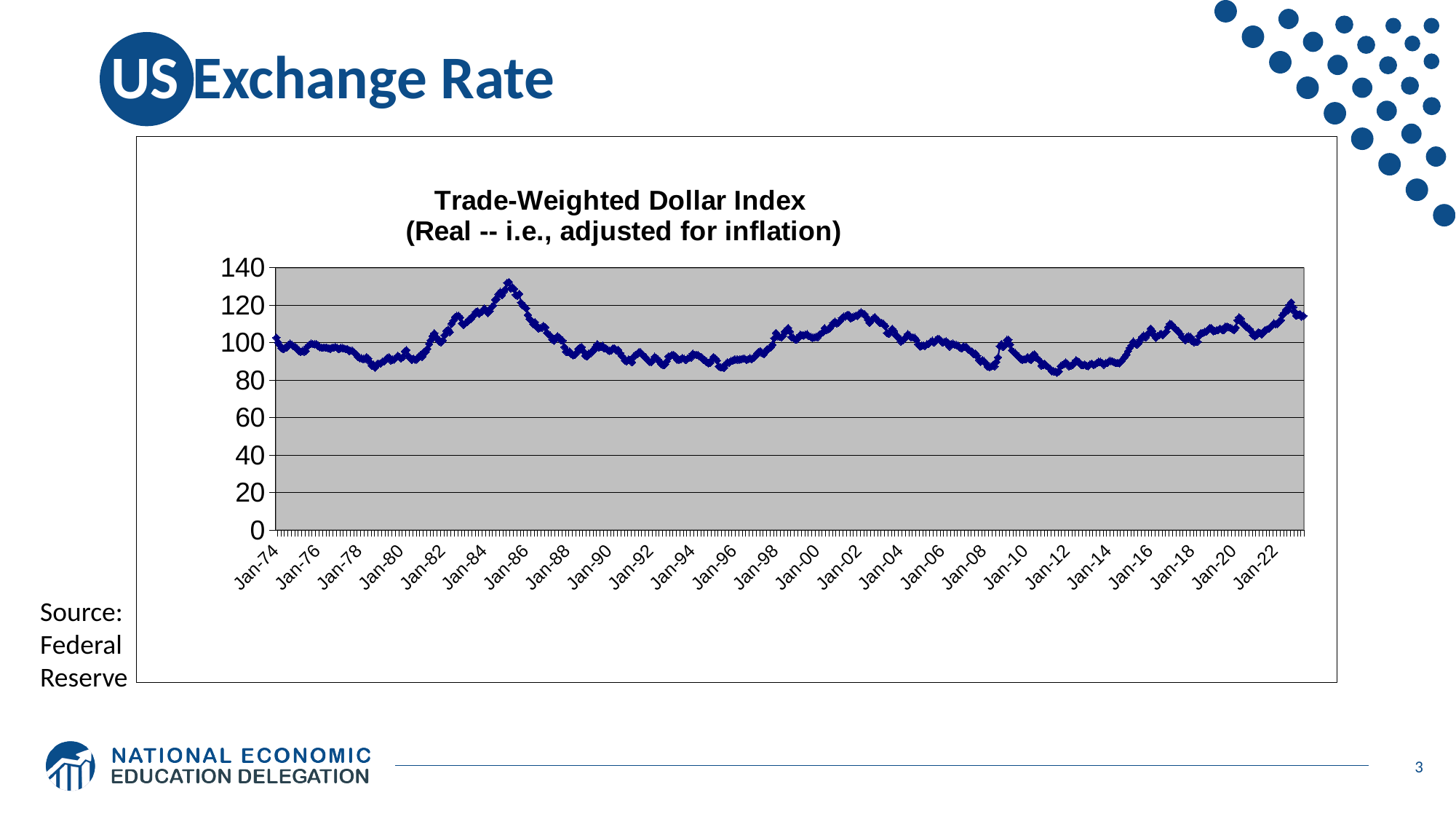
Is the peak value of the index near Jan-86 greater or less than 120? greater Is the value of the index at Jan-96 greater or less than 100? less What kind of chart is shown on the slide? line chart Is the value of the index at Jan-22 greater or less than 100? greater Around which x-axis label does the Trade-Weighted Dollar Index reach its highest value? Jan-86 What is the title of the chart? Trade-Weighted Dollar Index (Real -- i.e., adjusted for inflation) What is the highest value shown on the y-axis? 140 What is the source of the data shown in the chart? Federal Reserve Does the index rise or fall between Jan-12 and Jan-16? rise Does the index rise or fall between Jan-86 and Jan-88? fall